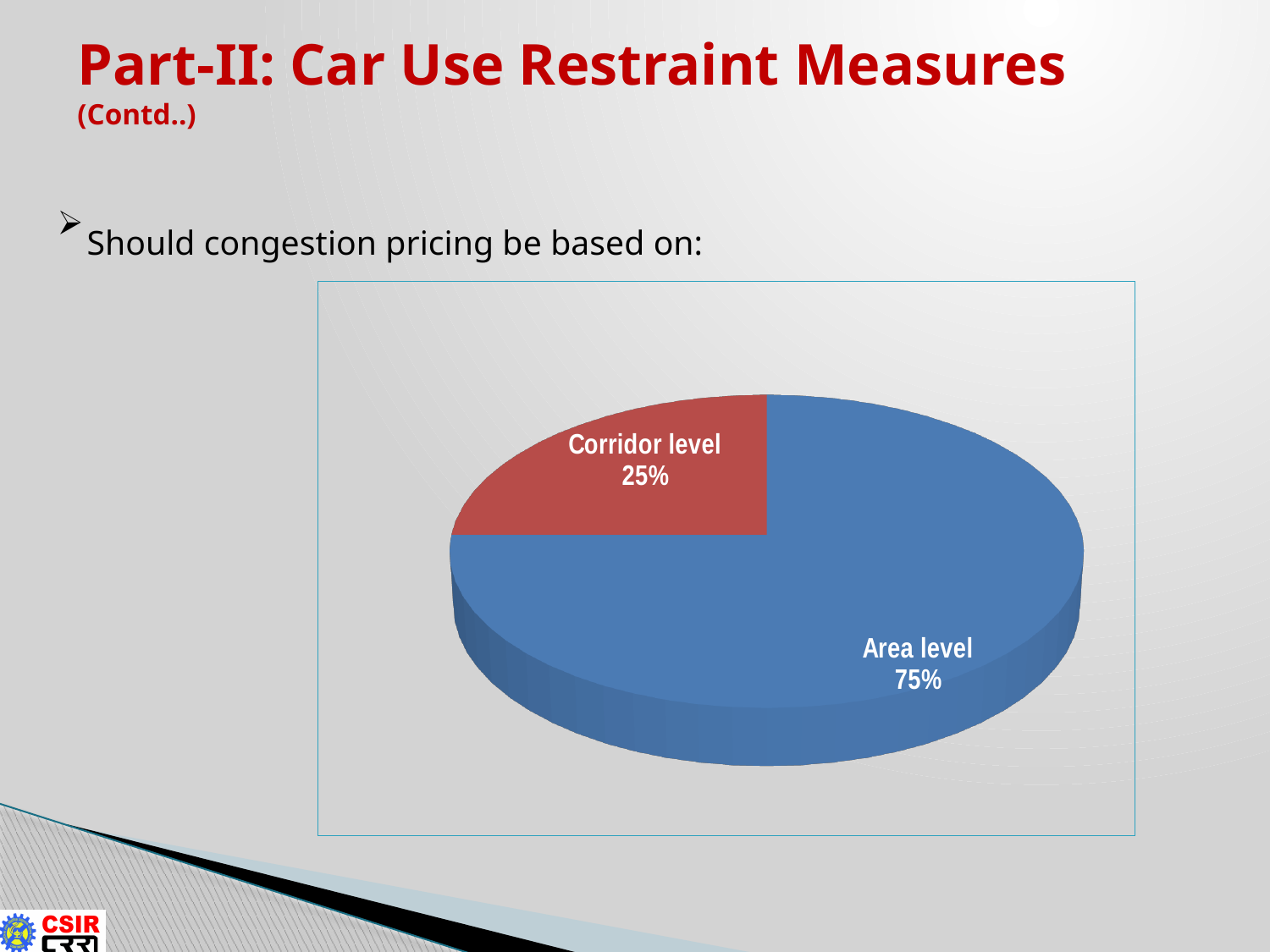
What share of the pie does Corridor level have? 25% What colour is the Corridor level slice? Red What is the combined share of the Area level and Corridor level slices? 100% What kind of chart is shown on the slide? Pie chart Which is larger, the Area level slice or the Corridor level slice? Area level Is the share for Corridor level greater or less than 50%? less How many slices does the pie chart have? 2 What is the difference in percentage points between the Area level and Corridor level slices? 50 What colour is the Area level slice? Blue Which slice of the pie is the largest? Area level Which slice of the pie is the smallest? Corridor level What share of the pie does Area level have? 75%